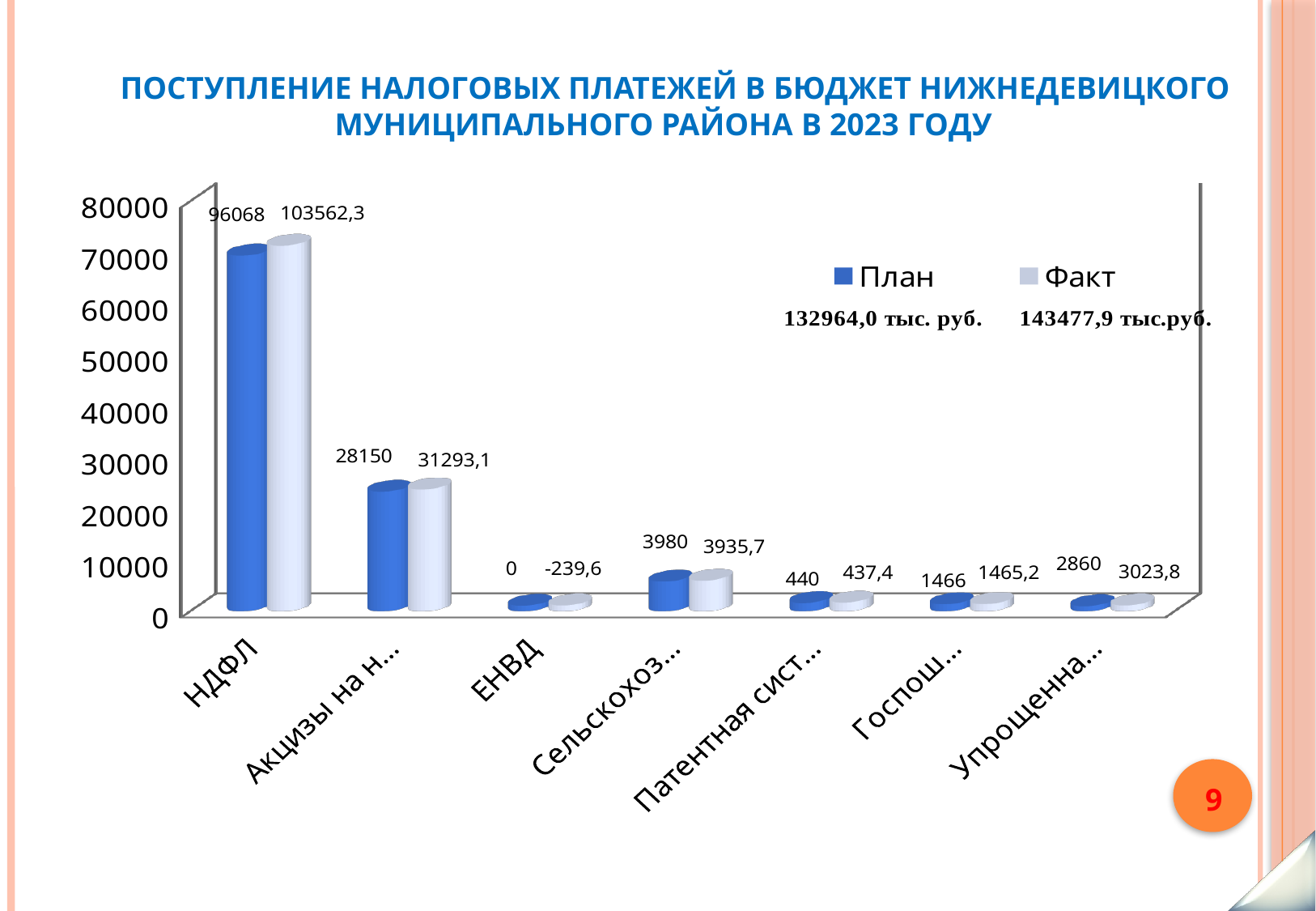
What is the Факт value for ЕНВД? -239,6 What kind of chart is shown on the slide? bar chart For the category labelled "Акцизы на н...", which is larger: План or Факт? Факт What total is printed under the Факт legend entry? 143477,9 тыс.руб. What is the План value for НДФЛ? 96068 What is the Факт value for НДФЛ? 103562,3 By how much does the Факт value for НДФЛ exceed the План value for НДФЛ? 7494,3 Which category has the highest Факт value? НДФЛ Which category has the lowest Факт value? ЕНВД What is the План value for ЕНВД? 0 How many categories are shown on the x axis? 7 How many series does the legend list? 2